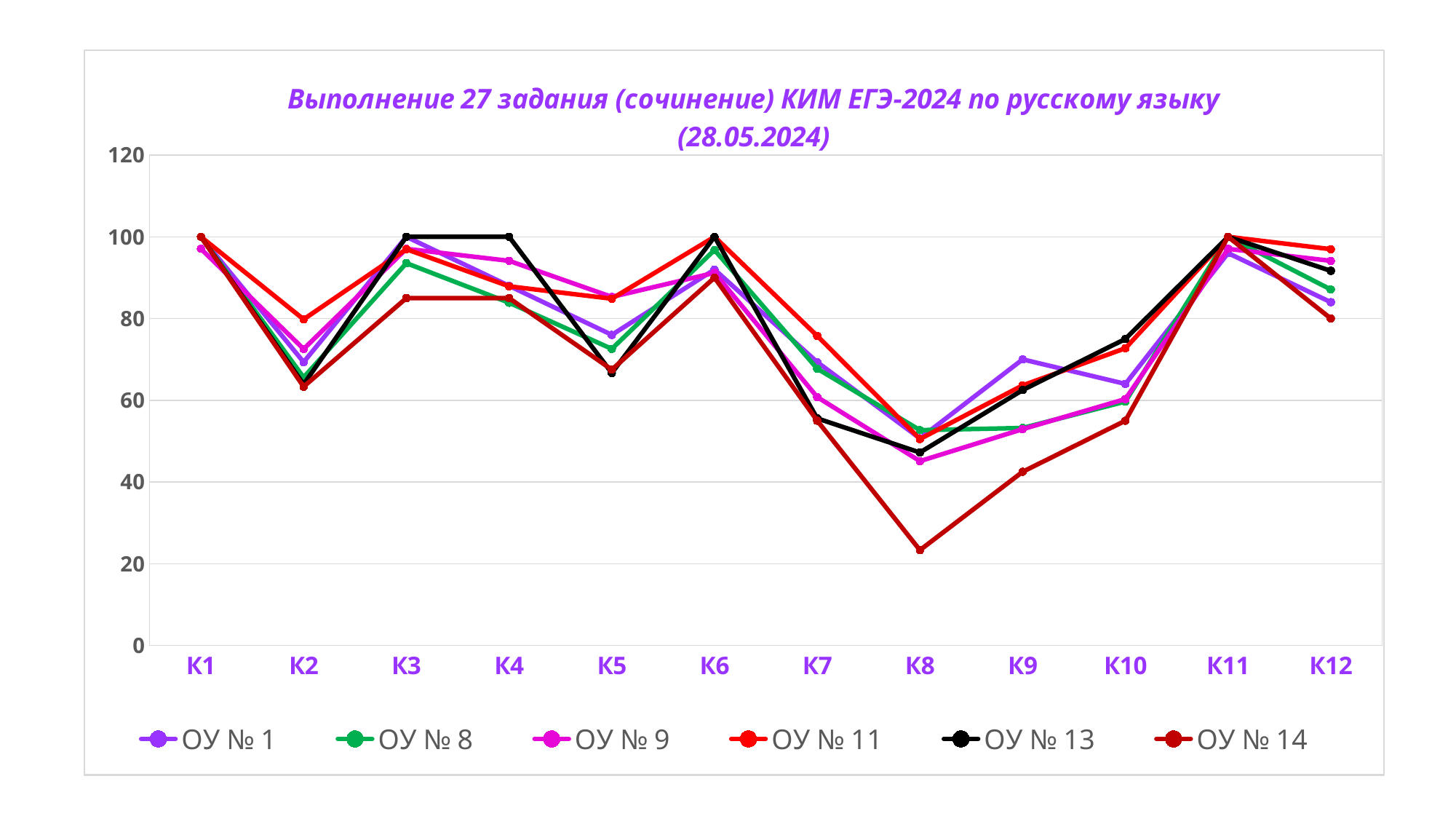
Is the value for ОУ № 14 at К8 greater or less than 40? less What is the value for ОУ № 14 at К12? 80 How many categories are shown on the x axis? 12 What kind of chart is shown on the slide? line chart At К8, which is larger: the value for ОУ № 13 or the value for ОУ № 14? ОУ № 13 Is the value for ОУ № 1 at К9 greater or less than 60? greater Which series has the lowest value at К8? ОУ № 14 Do the values for ОУ № 14 rise or fall from К8 to К11? rise How many series does the legend list? 6 Which series has the highest value at К2? ОУ № 11 What is the value for ОУ № 13 at К4? 100